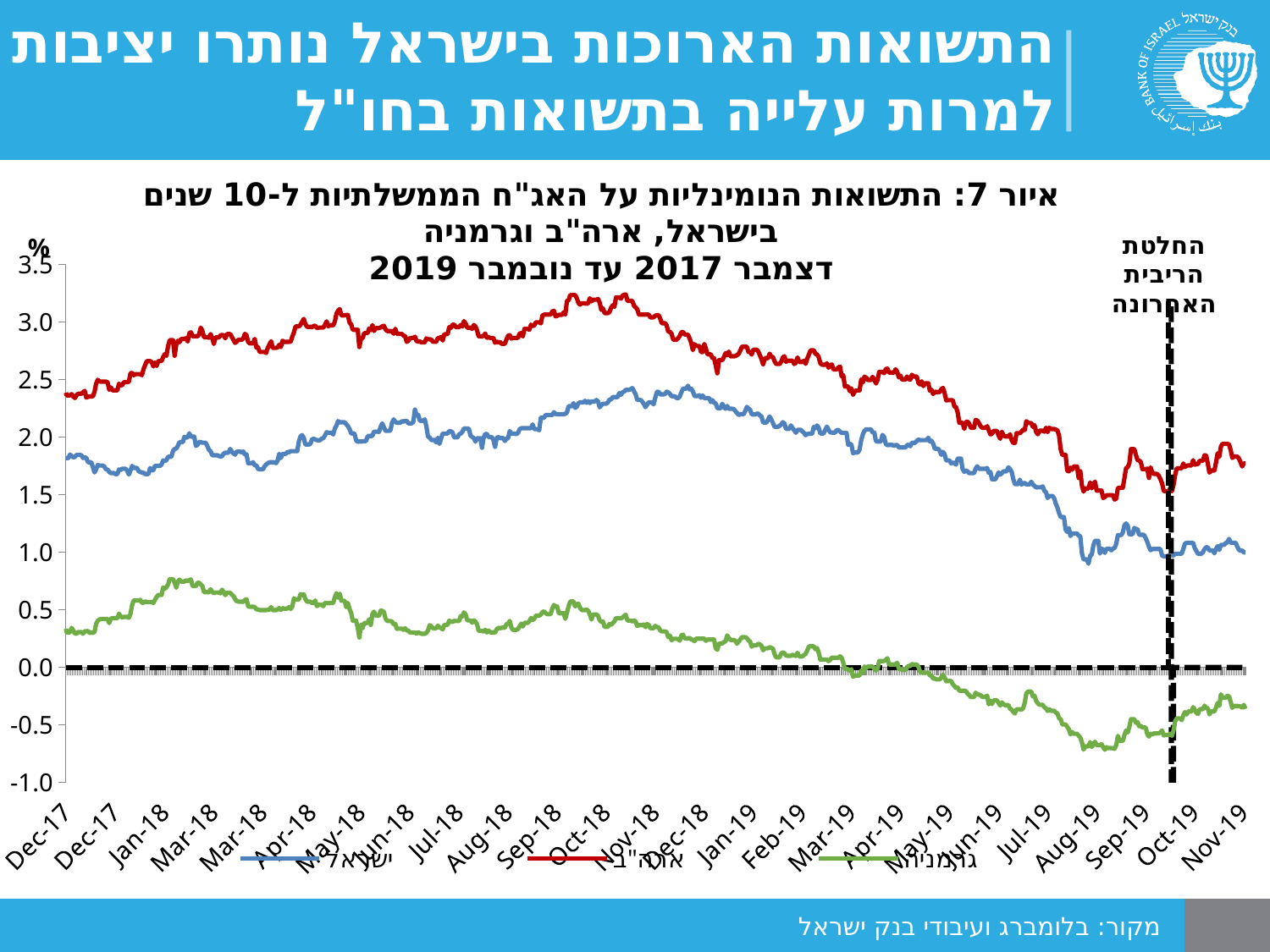
What kind of chart is shown on the slide? line chart Is the value for ישראל at Nov-19 greater or less than 1.5? less At Nov-19, which is larger: the value for ארה"ב or the value for גרמניה? ארה"ב Does the value for ישראל rise or fall from Dec-18 to Nov-19? fall Is the value for גרמניה at Nov-19 greater or less than 0.0? less What colour is the line for ישראל? blue What does the label next to the dashed vertical line say? החלטת הריבית האחרונה Which series has the lowest yield across the whole period shown? גרמניה Which series has the highest yield across the whole period shown? ארה"ב How many series does the legend list? 3 Is the value for ארה"ב at Oct-18 greater or less than 3.0? greater